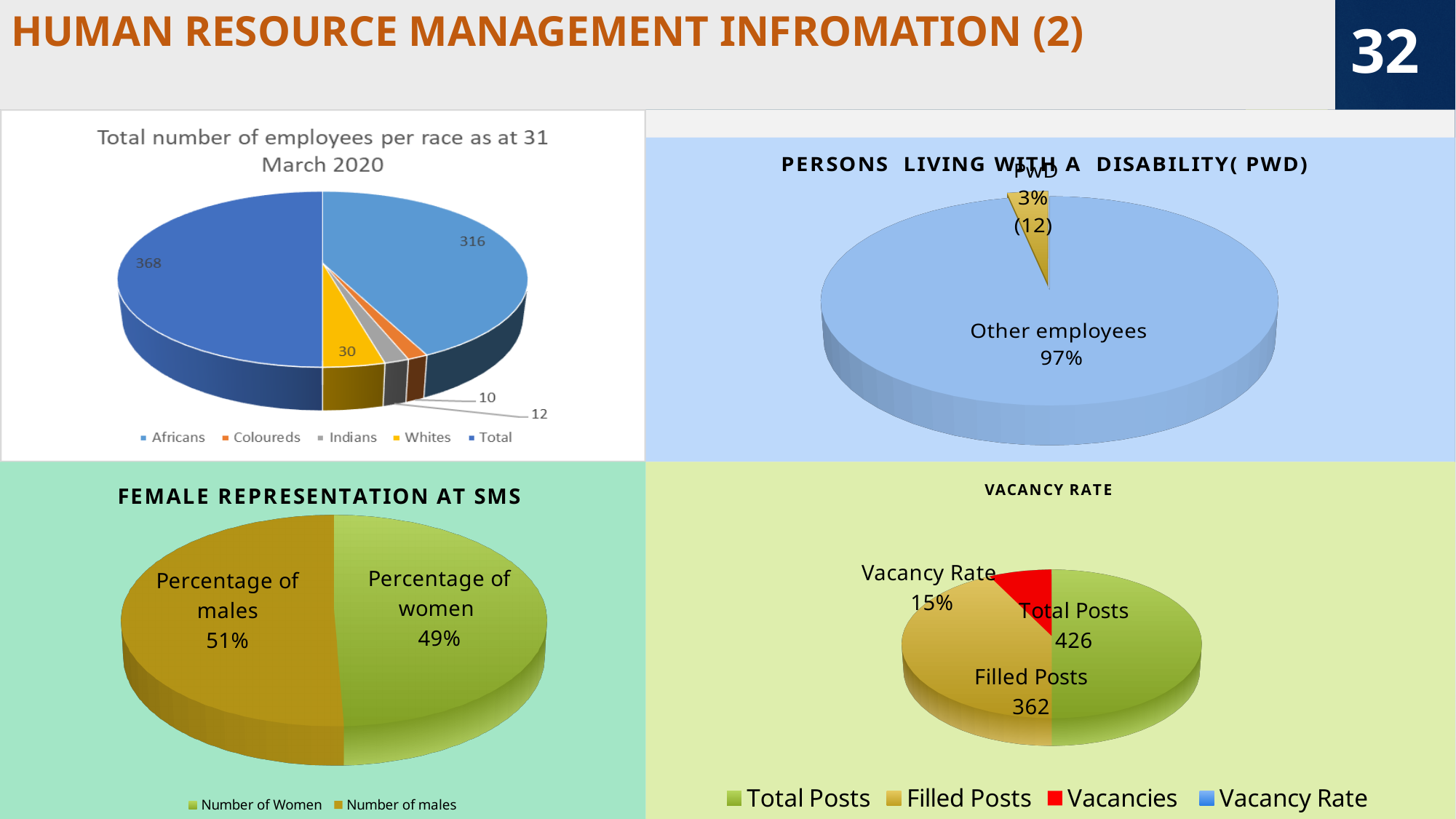
In the 'Total number of employees per race as at 31 March 2020' chart, how many employees are Africans? 316 What type of chart is the 'FEMALE REPRESENTATION AT SMS' chart? Pie chart In the 'Total number of employees per race as at 31 March 2020' chart, which race group has the largest number of employees? Africans In the 'PERSONS LIVING WITH A DISABILITY (PWD)' chart, what percentage is shown for Other employees? 97% In the 'VACANCY RATE' chart, what is the value for Total Posts? 426 In the 'FEMALE REPRESENTATION AT SMS' chart, which is larger, the percentage of males or the percentage of women? Percentage of males In the 'PERSONS LIVING WITH A DISABILITY (PWD)' chart, what percentage of employees are PWD? 3% In the 'VACANCY RATE' chart, what is the Vacancy Rate? 15% In the 'Total number of employees per race as at 31 March 2020' chart, what is the value shown for Total? 368 In the 'FEMALE REPRESENTATION AT SMS' chart, what is the percentage of males? 51% In the 'Total number of employees per race as at 31 March 2020' chart, how many employees are Whites? 30 In the 'VACANCY RATE' chart, what is the difference between Total Posts and Filled Posts? 64